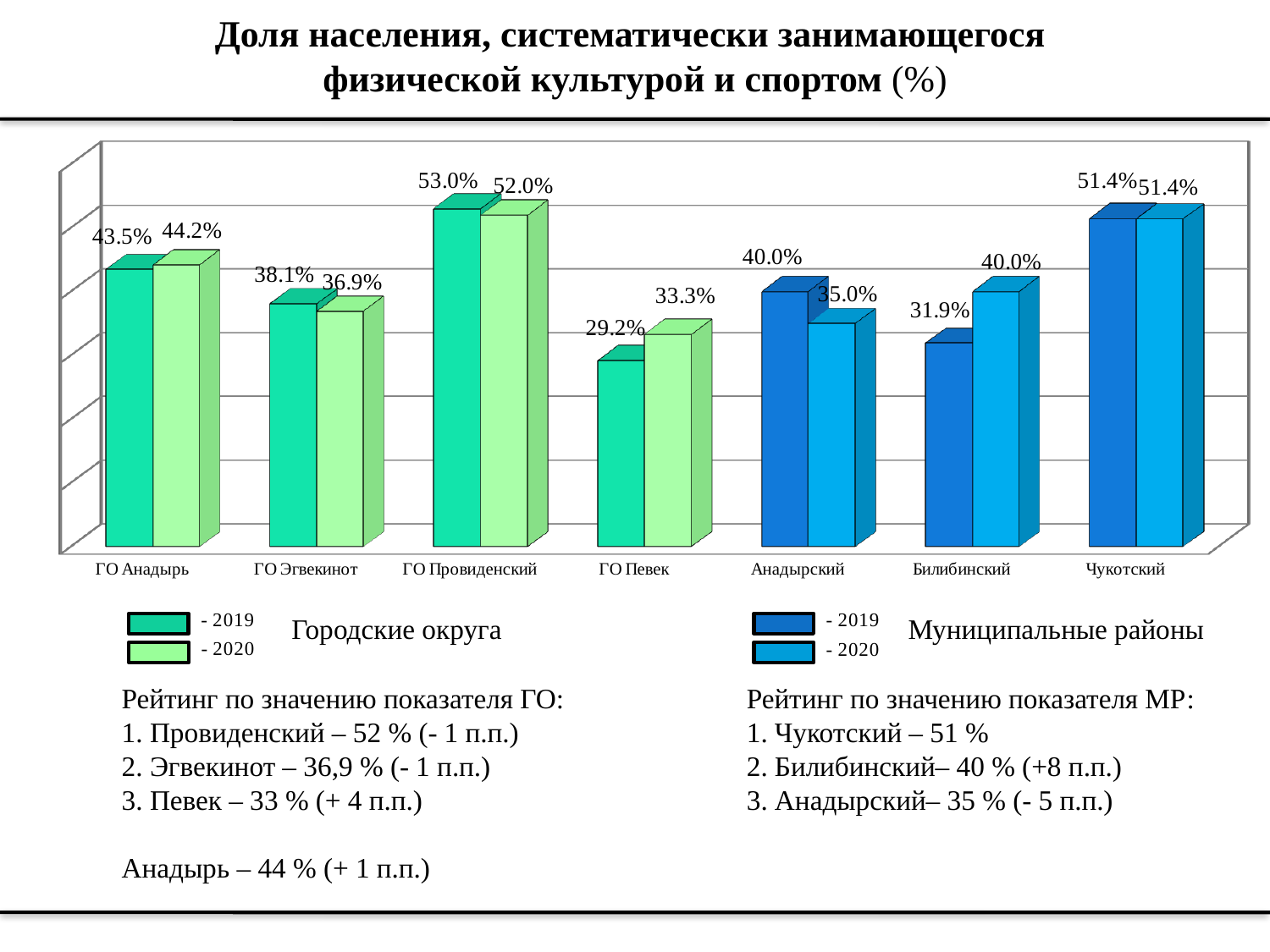
What is the difference between the 2019 and 2020 values for Анадырский? 5.0 percentage points Which category has the highest 2020 value? ГО Провиденский Which two years are listed in the chart legends? 2019 and 2020 Which is larger: the 2020 value for ГО Эгвекинот or the 2020 value for Анадырский? ГО Эгвекинот Did the value for ГО Певек rise or fall from 2019 to 2020? Rise What is the difference between the 2020 and 2019 values for Билибинский? 8.1 percentage points What is the 2020 value for ГО Певек? 33.3% Which category has the lowest 2019 value? ГО Певек What is the 2020 value for ГО Анадырь? 44.2% What kind of chart is shown on the slide? Bar chart What is the 2019 value for Билибинский? 31.9% How many categories are shown on the x axis? 7